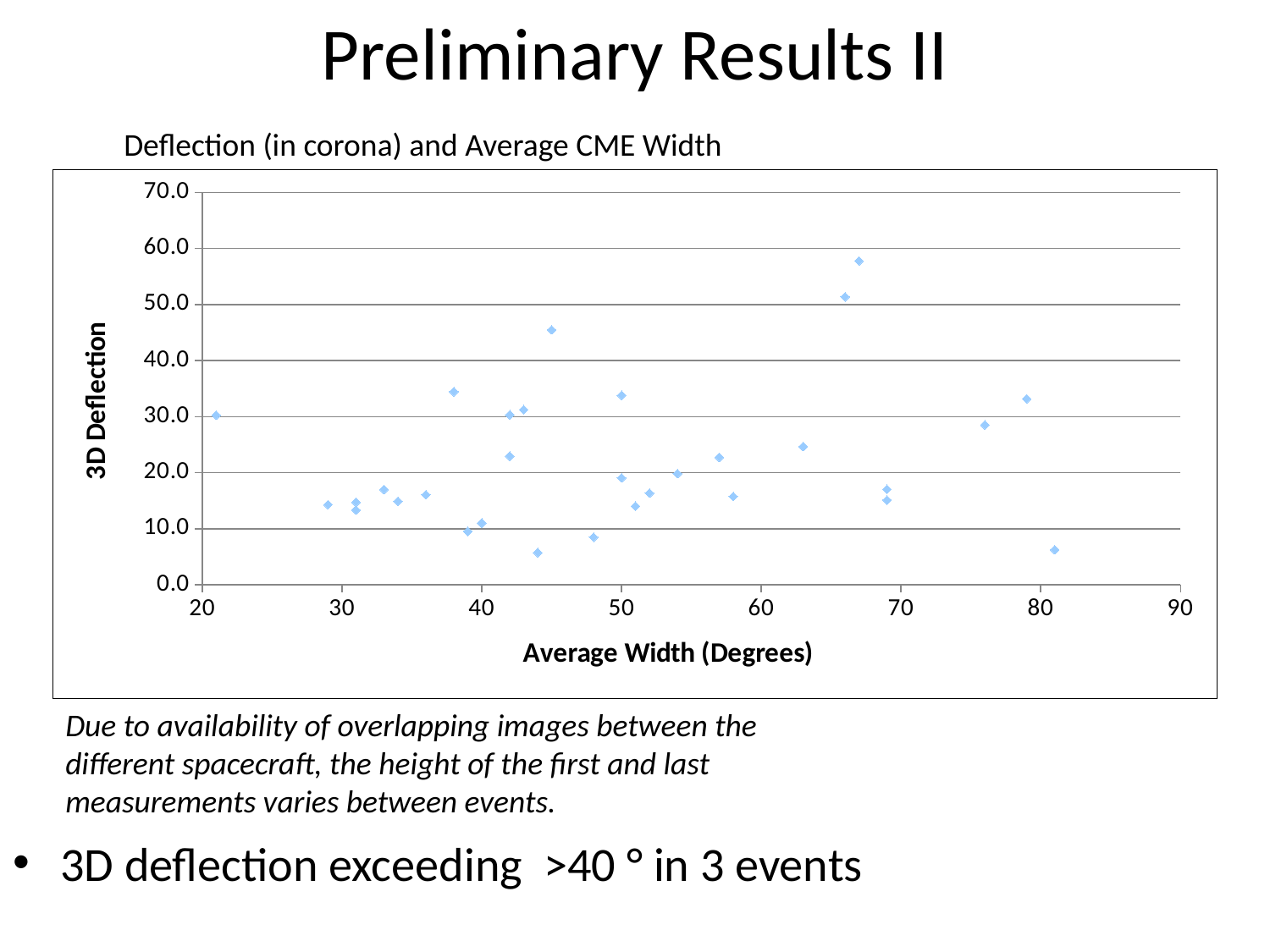
What is the title of the chart? Deflection (in corona) and Average CME Width How many points on the chart have a 3D deflection greater than 40.0? 3 What is the maximum value shown on the vertical axis of the chart? 70.0 Is the 3D deflection for the point at an average width of 81 degrees greater or less than 10.0? less Is the 3D deflection for the point at an average width of 45 degrees greater or less than 40.0? greater Which point has a larger 3D deflection: the one at an average width of 66 degrees or the one at 76 degrees? 66 degrees Is the 3D deflection for the point at an average width of 38 degrees greater or less than 30.0? greater What kind of chart is shown on the slide? scatter chart What is the label of the horizontal axis of the chart? Average Width (Degrees)